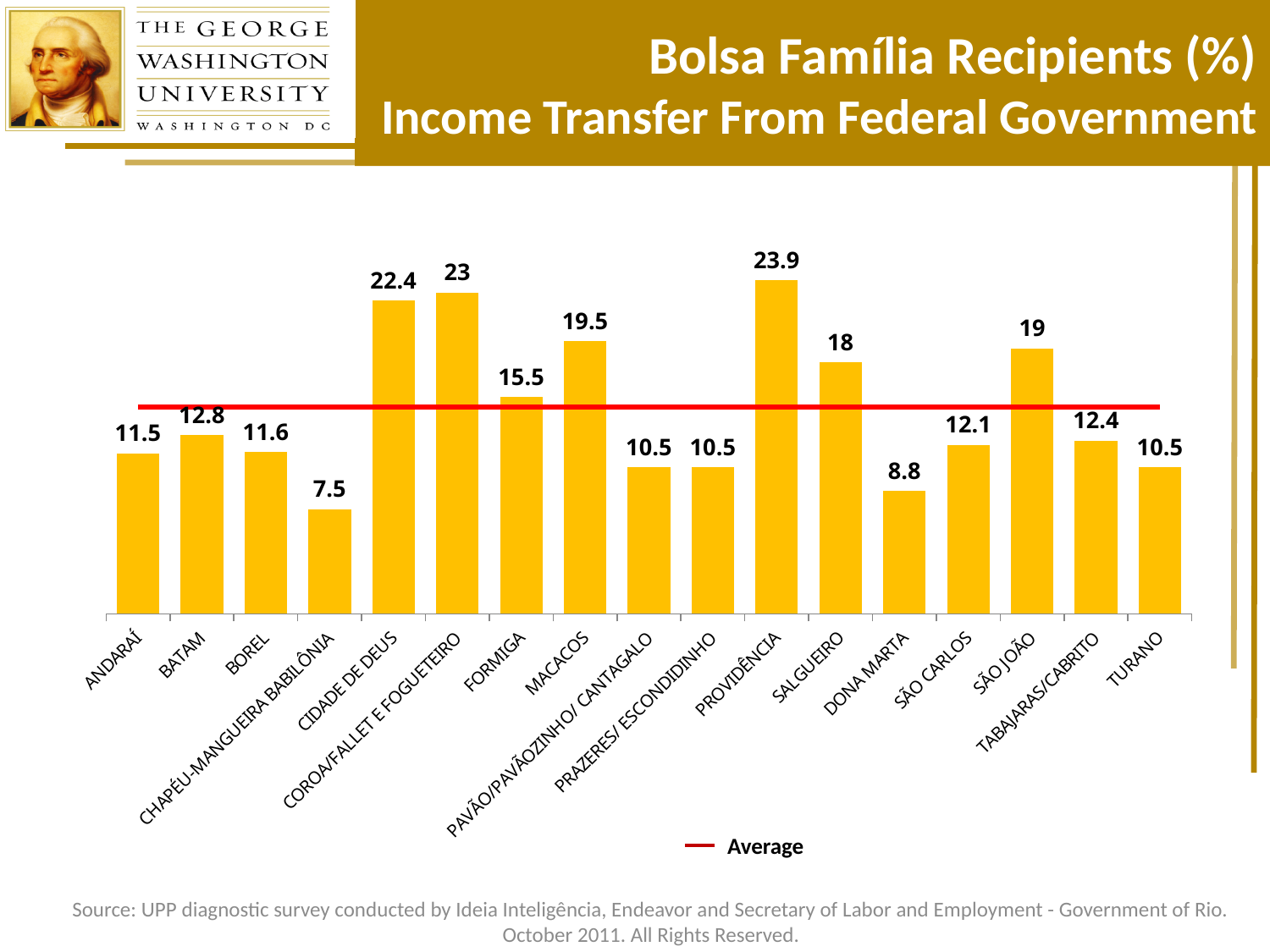
Which is larger, the value for Formiga or the value for Batam? Formiga How many communities are shown on the x axis? 17 What is the value for Chapéu-Mangueira Babilônia? 7.5 What is the value for Providência? 23.9 Which community has the highest percentage of Bolsa Família recipients? Providência What is the difference between the values for Cidade de Deus and Dona Marta? 13.6 What is the value for Salgueiro? 18 What is the difference between the values for Macacos and São João? 0.5 Which community has the lowest percentage of Bolsa Família recipients? Chapéu-Mangueira Babilônia Which is larger, the value for Coroa/Fallet e Fogueteiro or the value for Salgueiro? Coroa/Fallet e Fogueteiro What does the red horizontal line represent according to the legend? Average What kind of chart is shown on the slide? Bar chart